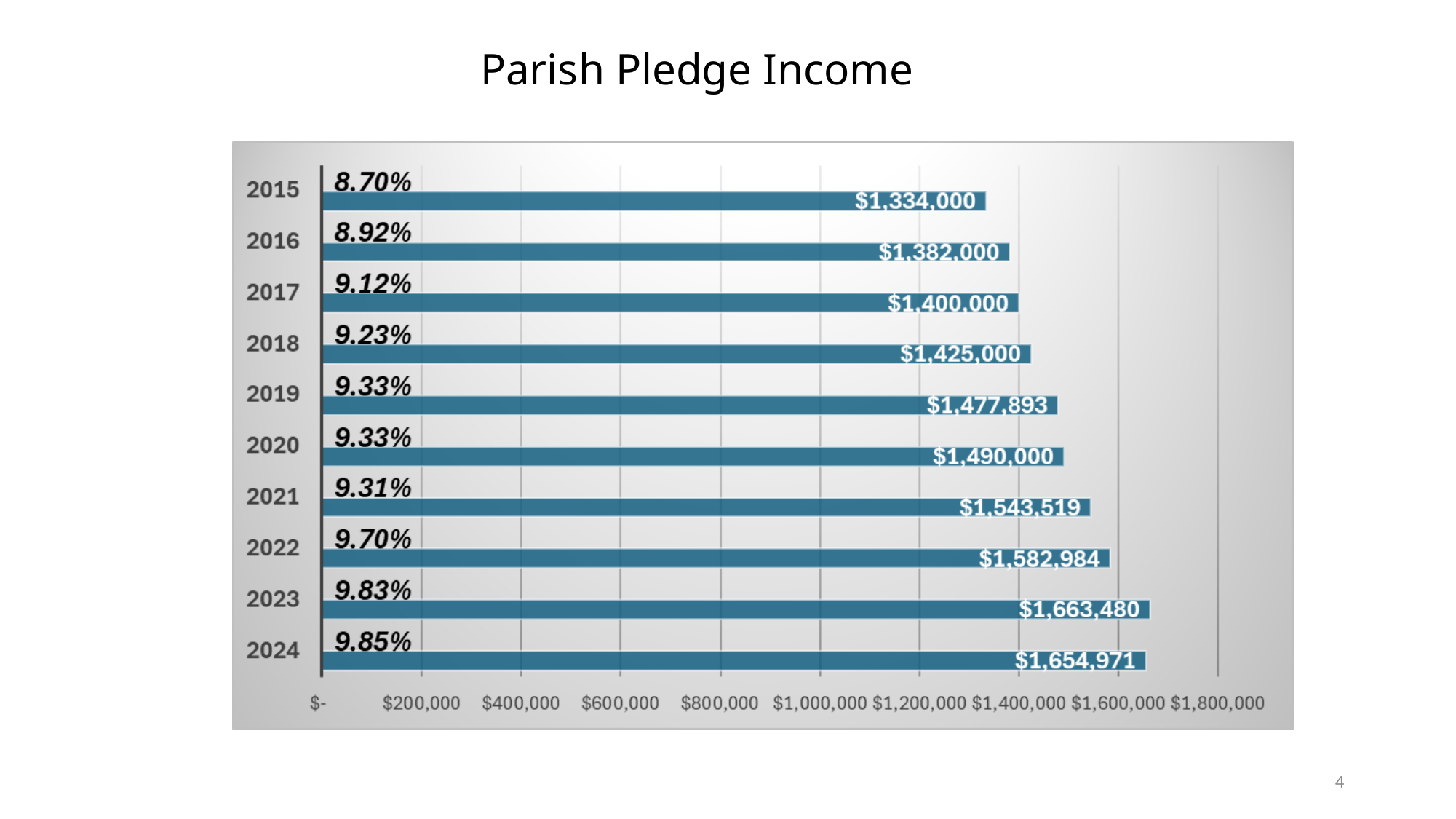
How many years are shown in the chart? 10 What kind of chart is shown on the slide? bar chart What is the difference between the pledge income for 2024 and 2015? $320,971 What is the pledge income value shown for 2024? $1,654,971 What is the pledge income value shown for 2019? $1,477,893 Is the pledge income for 2015 greater or less than $1,400,000? less What is the title of the chart? Parish Pledge Income What percentage is printed next to the 2022 bar? 9.70% Which year has the lowest pledge income? 2015 Which year has the highest pledge income? 2023 Which year has the larger pledge income, 2020 or 2021? 2021 What is the difference between the pledge income for 2023 and 2022? $80,496